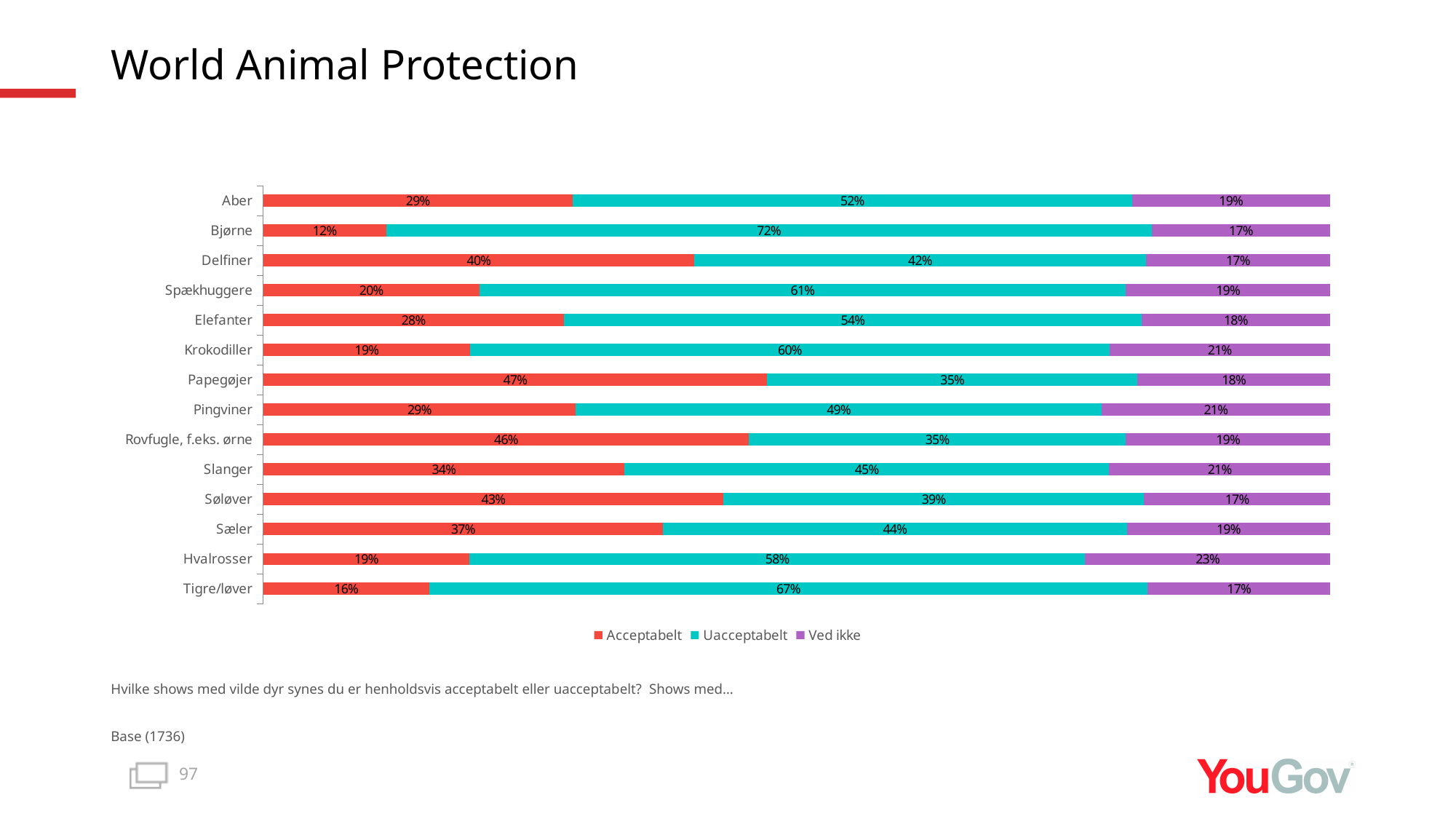
Which category has the highest 'Uacceptabelt' value? Bjørne What percentage of respondents found shows with Bjørne 'Uacceptabelt'? 72% What is the 'Acceptabelt' value for Papegøjer? 47% How many series does the legend list? 3 What is the 'Ved ikke' value for Hvalrosser? 23% Which is larger, the 'Acceptabelt' value for Søløver or for Sæler? Søløver Which category has the highest 'Ved ikke' value? Hvalrosser What kind of chart is shown on the slide? Stacked bar chart Which category has the lowest 'Acceptabelt' value? Bjørne How many animal categories are shown in the chart? 14 What is the difference between the 'Uacceptabelt' values for Tigre/løver and Delfiner? 25% What is the total of the three segments for the Krokodiller bar? 100%